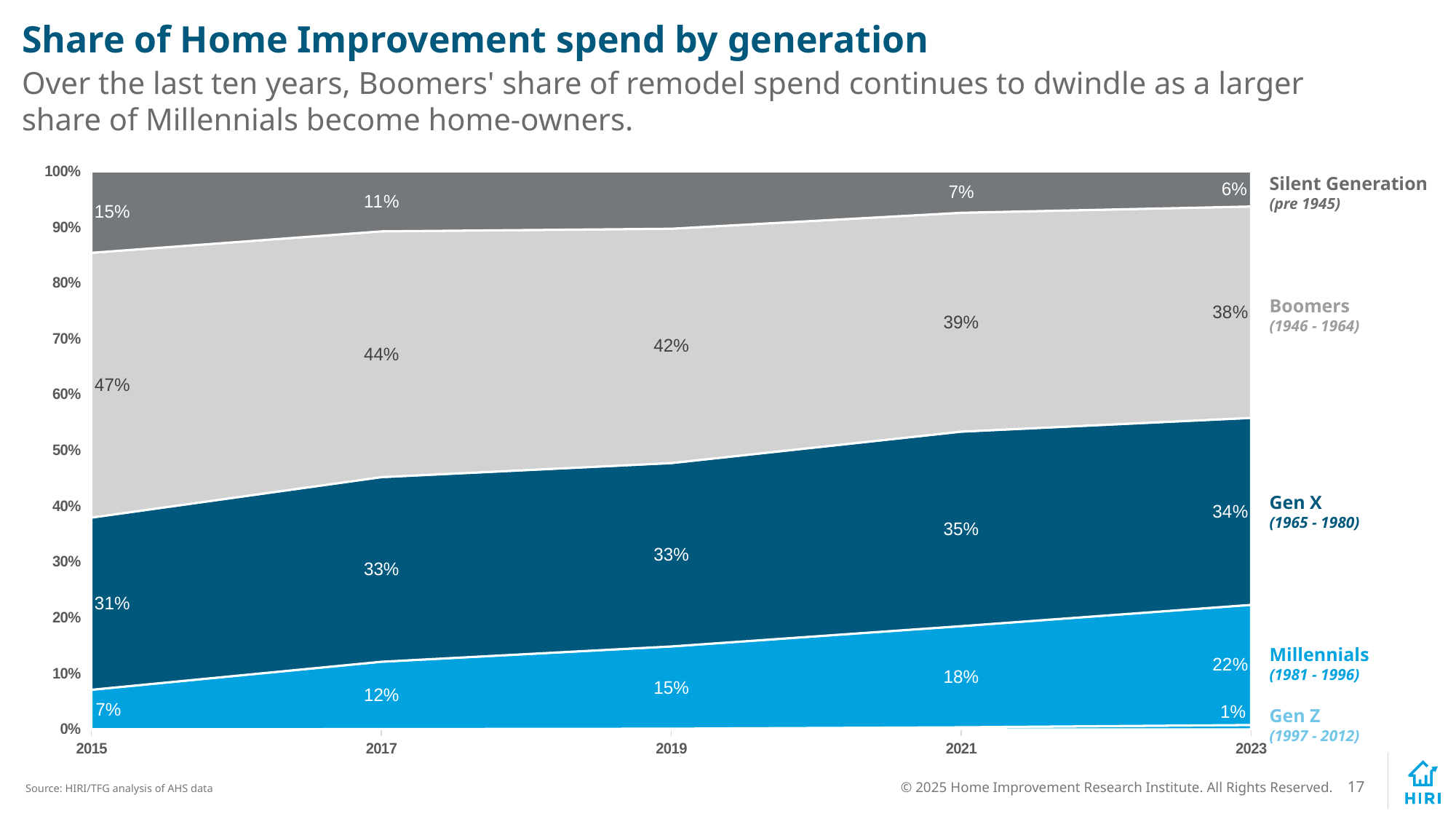
What was the Silent Generation's share of spend in 2021? 7% What share of home improvement spend did Boomers have in 2015? 47% Does the Millennials' share rise or fall from 2015 to 2023? Rise How many generations are labelled on the chart? 5 By how many percentage points did Boomers' share fall from 2015 to 2023? 9 percentage points How many years are shown on the x axis? 5 What was Gen X's share of spend in 2019? 33% What was Gen Z's share of spend in 2023? 1% What share of home improvement spend did Millennials have in 2023? 22% Which was larger in 2021, Gen X's share or Boomers' share? Boomers Which generation had the largest share of spend in 2023? Boomers